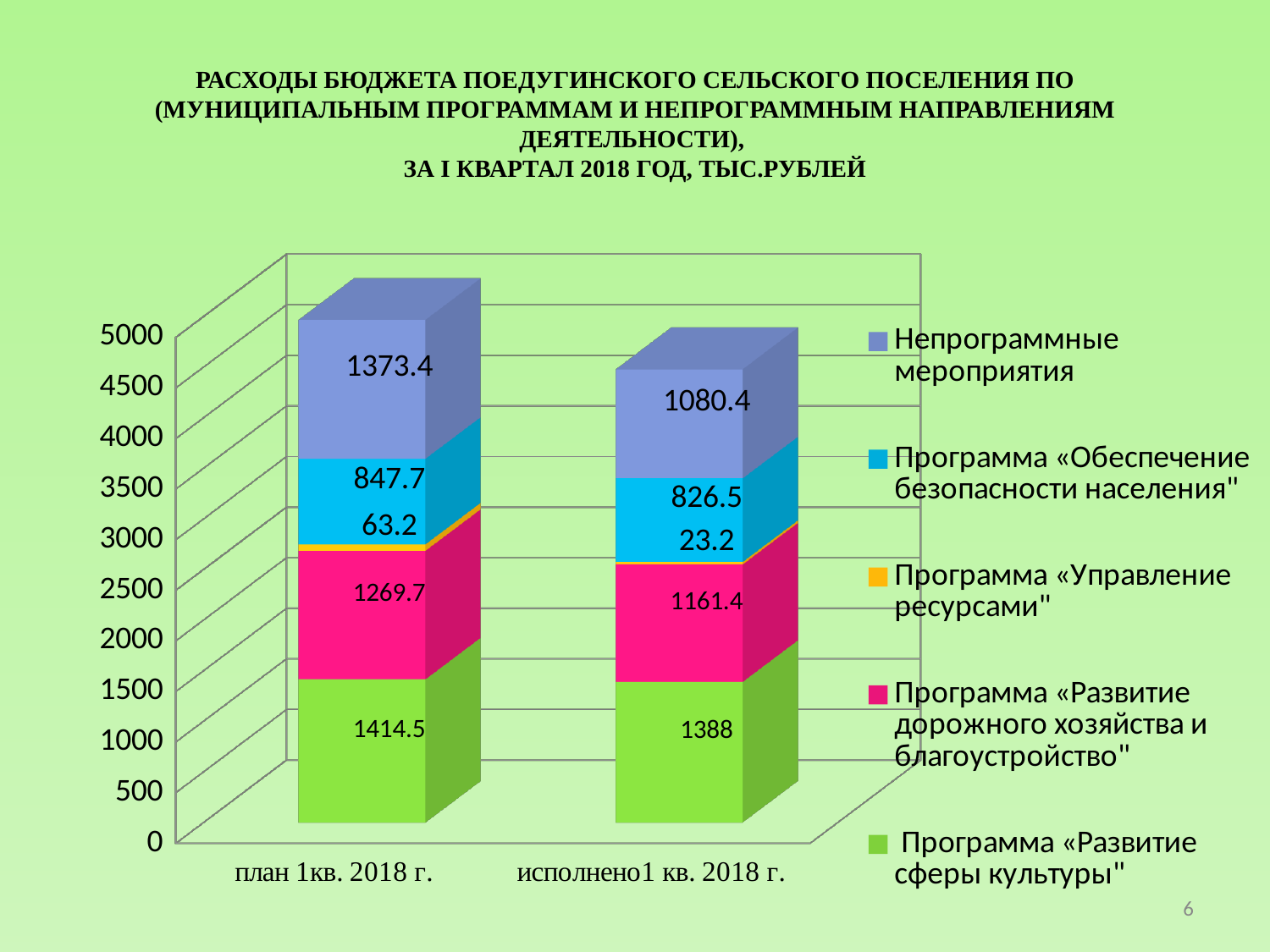
What kind of chart is shown on the slide? stacked bar chart How many categories are shown on the x axis? 2 What is the value for Программа «Развитие сферы культуры» in «исполнено1 кв. 2018 г.»? 1388 What is the value for Программа «Обеспечение безопасности населения» in «план 1кв. 2018 г.»? 847.7 What is the value for «Непрограммные мероприятия» in «план 1кв. 2018 г.»? 1373.4 What is the difference between the «Непрограммные мероприятия» values for «план 1кв. 2018 г.» and «исполнено1 кв. 2018 г.»? 293 How many series does the legend list? 5 What is the total of the «исполнено1 кв. 2018 г.» stacked bar? 4479.5 Which series has the largest value in the «план 1кв. 2018 г.» bar? Программа «Развитие сферы культуры» Which is larger: Программа «Развитие дорожного хозяйства и благоустройство» for «план 1кв. 2018 г.» or for «исполнено1 кв. 2018 г.»? план 1кв. 2018 г. What is the value for Программа «Управление ресурсами» in «исполнено1 кв. 2018 г.»? 23.2 Which series has the smallest value in the «план 1кв. 2018 г.» bar? Программа «Управление ресурсами»